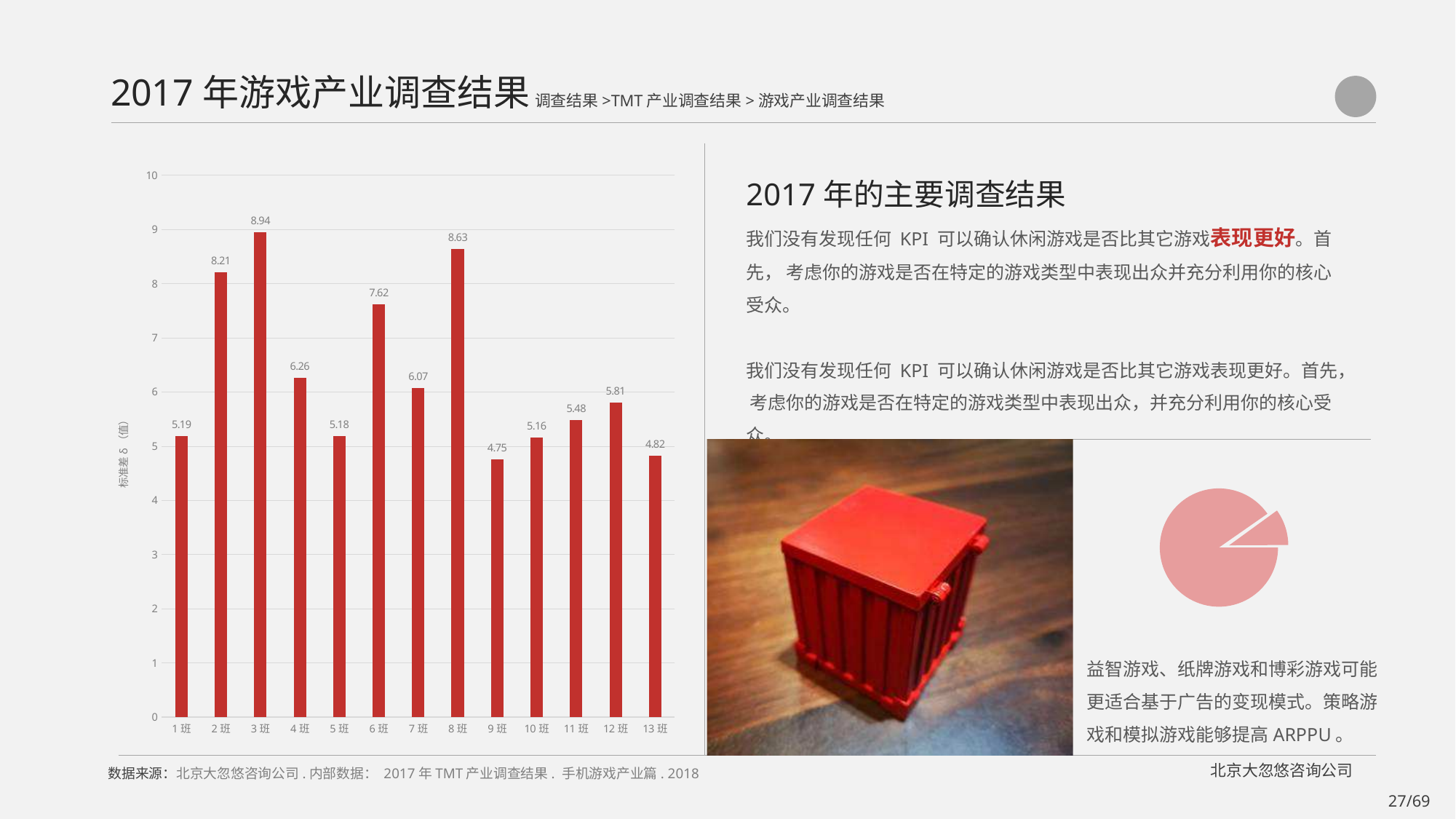
In the bar chart on the left, what is the value for 9班? 4.75 In the bar chart on the left, which category has the highest value? 3班 What kind of chart is the chart on the left of the slide? bar chart In the bar chart on the left, which is larger, the value for 6班 or the value for 7班? 6班 In the bar chart on the left, what is the value for 12班? 5.81 In the bar chart on the left, what is the value for 3班? 8.94 In the bar chart on the left, is the value for 8班 greater or less than 8? greater What is the label on the vertical axis of the bar chart on the left? 标准差 δ（值） In the bar chart on the left, which category has the lowest value? 9班 In the bar chart on the left, what is the difference between the values for 3班 and 9班? 4.19 In the bar chart on the left, what is the difference between the values for 2班 and 1班? 3.02 How many categories are shown in the bar chart on the left? 13